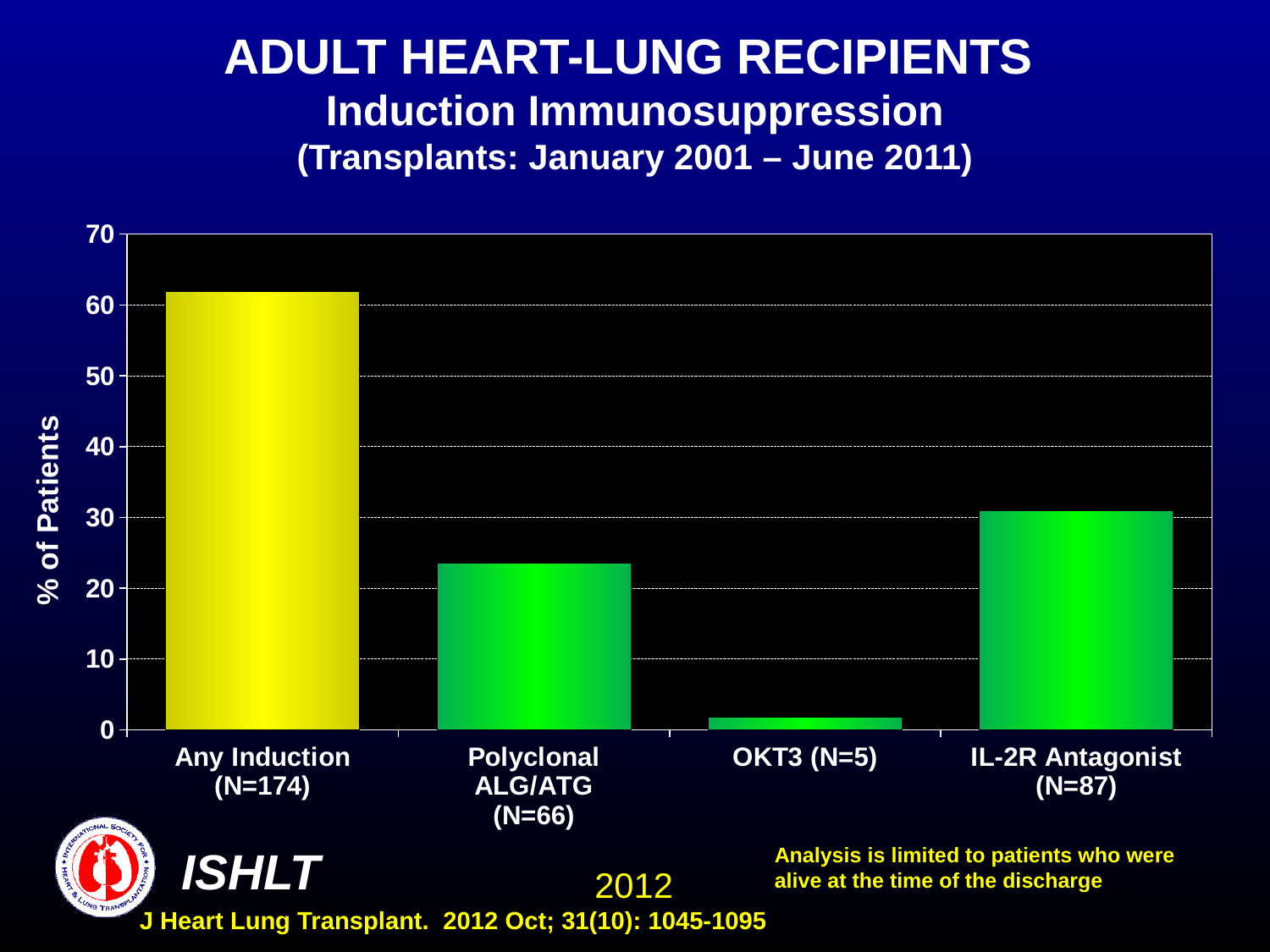
Is the value for Any Induction greater or less than 60? greater Which is larger, the value for IL-2R Antagonist or the value for Polyclonal ALG/ATG? IL-2R Antagonist Is the value for Polyclonal ALG/ATG greater or less than 20? greater Which is larger, the value for OKT3 or the value for Polyclonal ALG/ATG? Polyclonal ALG/ATG Which category has the highest percentage of patients? Any Induction (N=174) What is the N shown for the IL-2R Antagonist category? N=87 What kind of chart is shown on the slide? bar chart Which category has the lowest percentage of patients? OKT3 (N=5) How many categories are shown on the x axis? 4 What is the label of the y axis? % of Patients Is the value for OKT3 greater or less than 10? less